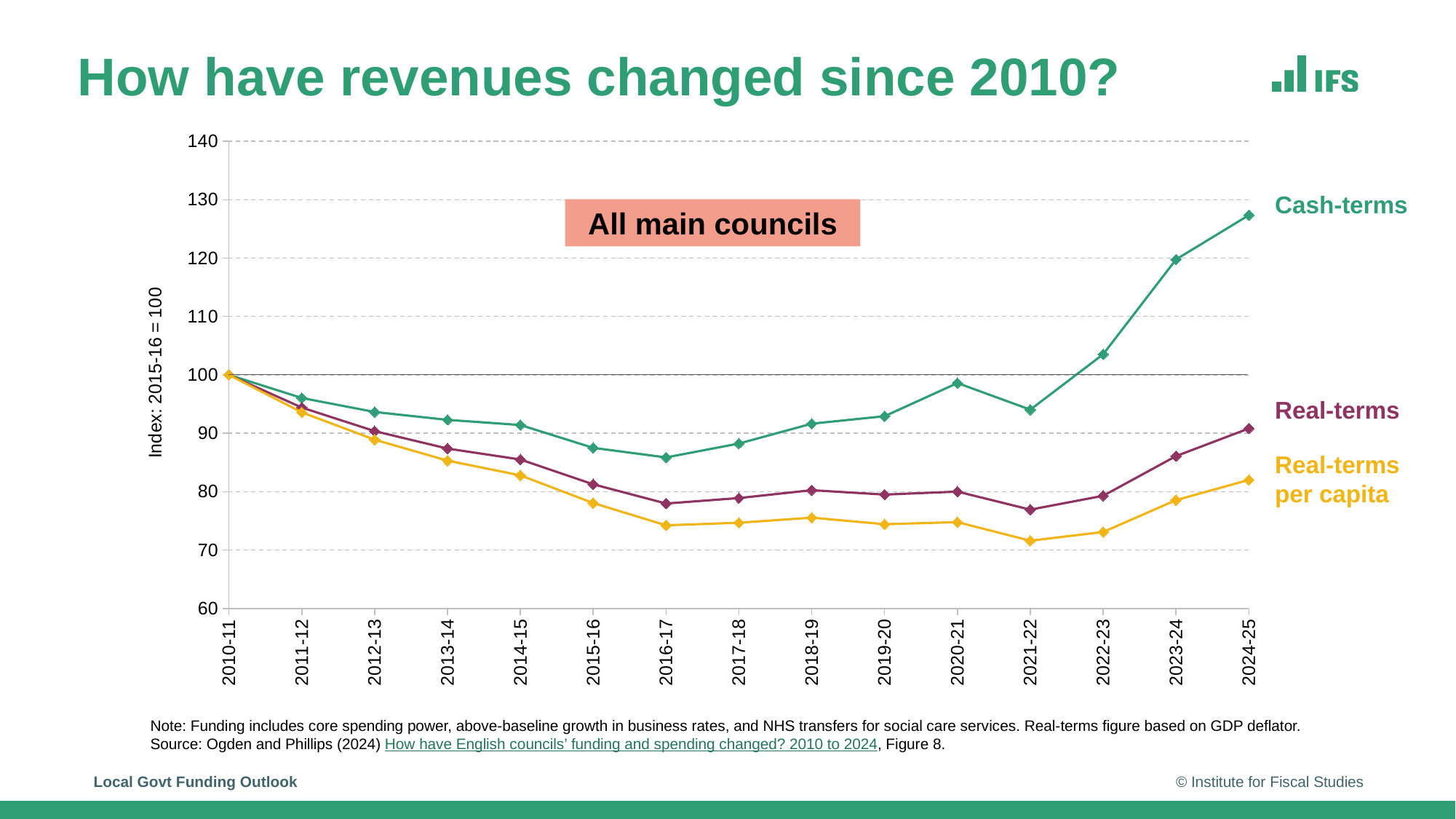
How many years are shown along the x axis of the chart? 15 What is the label on the y axis of the chart? Index: 2015-16 = 100 In which year is the Real-terms per capita series at its lowest? 2021-22 Which series has the highest value in 2024-25? Cash-terms In 2024-25, which is larger: Real-terms or Real-terms per capita? Real-terms What is the index value for Cash-terms in 2010-11? 100 Is the Cash-terms value for 2024-25 greater or less than 120? greater What kind of chart is shown on the slide? Line chart Is the Cash-terms value for 2016-17 greater or less than 90? less Is the Real-terms per capita value for 2021-22 greater or less than 80? less How many series are plotted on the chart? 3 Does the Cash-terms series rise or fall between 2021-22 and 2024-25? Rise